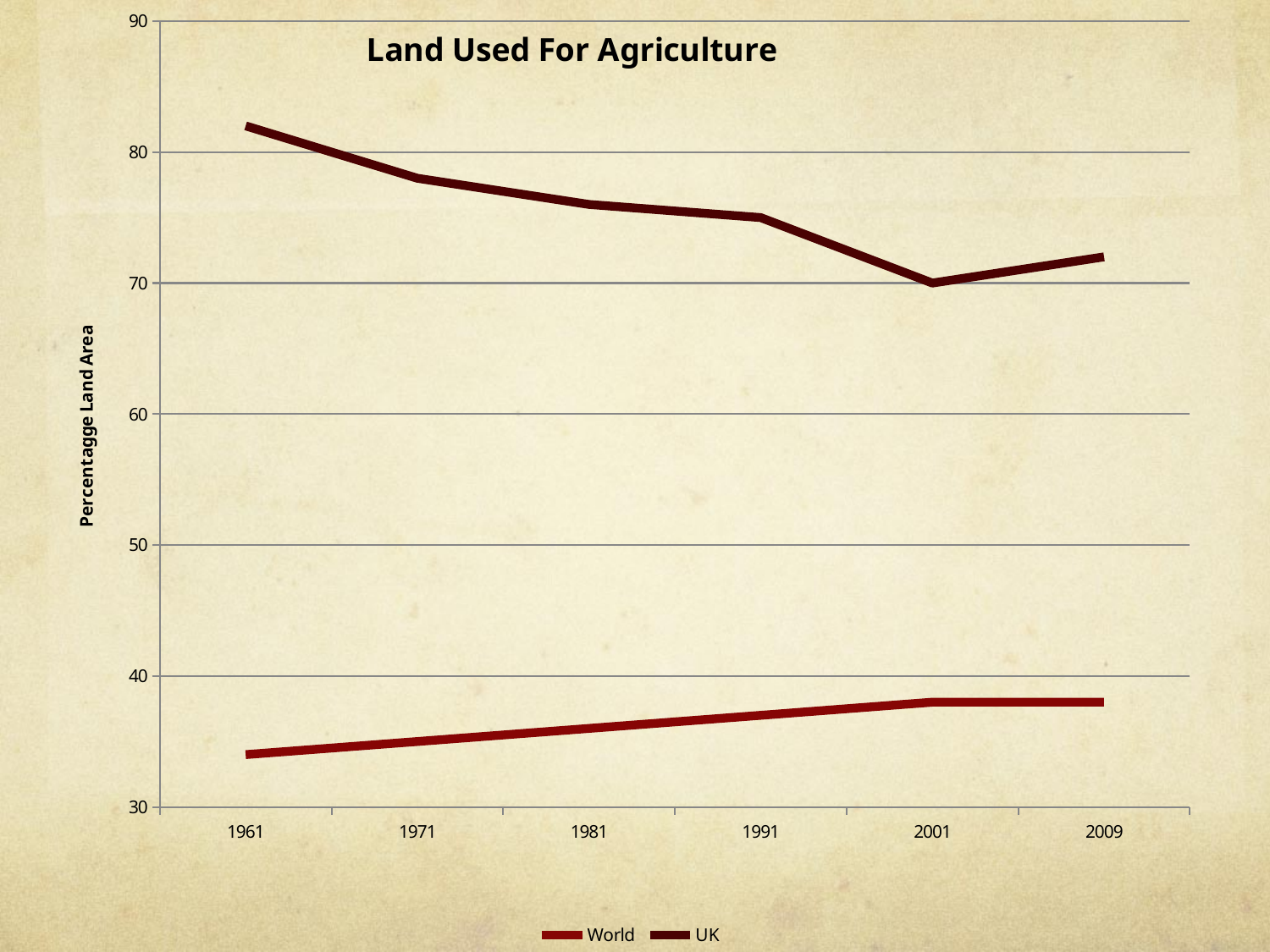
Which series has the higher value in 1961, World or UK? UK How many series does the legend list? 2 In which year is the UK value highest? 1961 In which year is the UK value lowest? 2001 Does the UK line generally rise or fall from 1961 to 2001? fall Does the World line rise or fall from 1961 to 2001? rise How many years are marked on the x axis? 6 What is the title of the chart? Land Used For Agriculture What kind of chart is shown on the slide? line chart Is the UK value for 1961 greater or less than 80? greater Is the World value for 2009 greater or less than 40? less What is the label on the vertical axis? Percentagge Land Area